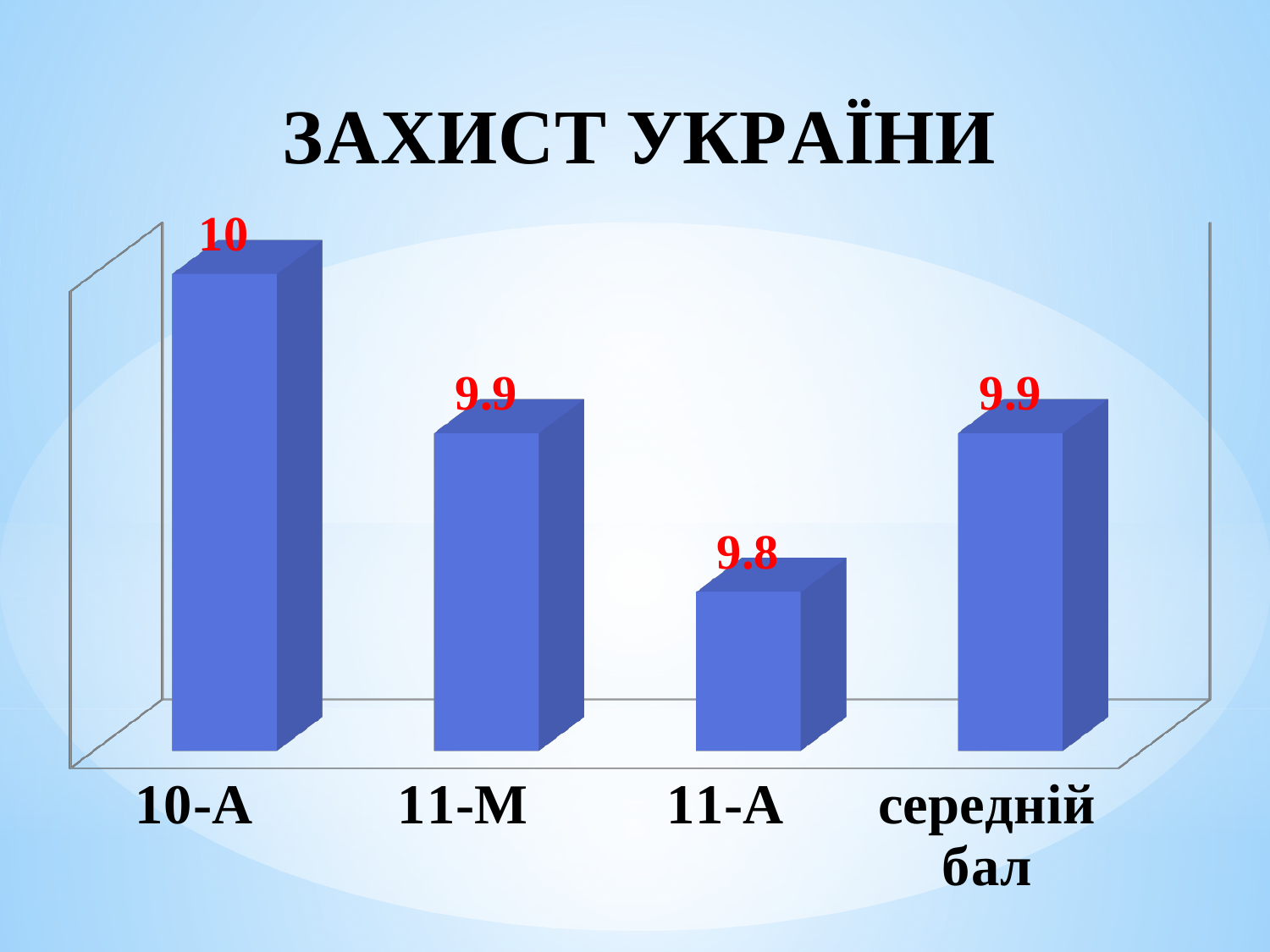
What is the value for 11-М? 9.9 Which category has the lowest value? 11-А What is the difference between the values for 10-А and 11-А? 0.2 How many categories are shown in the chart? 4 What is the difference between the values for 11-М and 11-А? 0.1 What kind of chart is shown on the slide? bar chart What is the value for 10-А? 10 Which category has the highest value? 10-А What is the title of the slide? ЗАХИСТ УКРАЇНИ What is the value for середній бал? 9.9 What is the value for 11-А? 9.8 Which is larger, the value for 10-А or the value for 11-М? 10-А